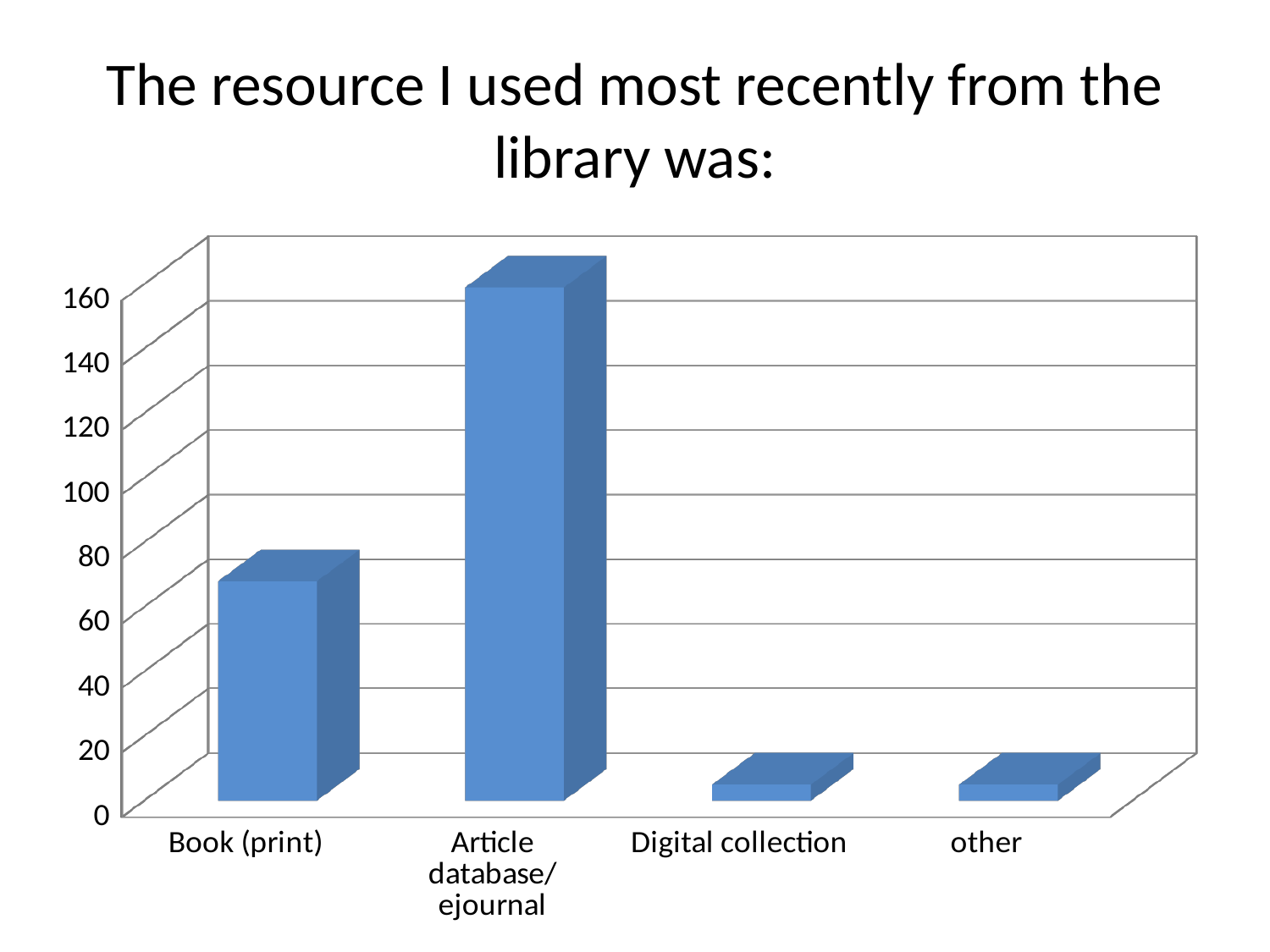
What kind of chart is shown on the slide? bar chart Which is larger, the value for Book (print) or the value for Digital collection? Book (print) Is the value for other greater or less than 20? less Is the value for Book (print) greater or less than 60? greater Is the value for Digital collection greater or less than 20? less What is the highest value labelled on the vertical axis of the chart? 160 Which category has the highest value in the chart? Article database/ejournal Which is larger, the value for Book (print) or the value for Article database/ejournal? Article database/ejournal How many categories are shown on the x axis of the chart? 4 What is the title of the chart on the slide? The resource I used most recently from the library was: